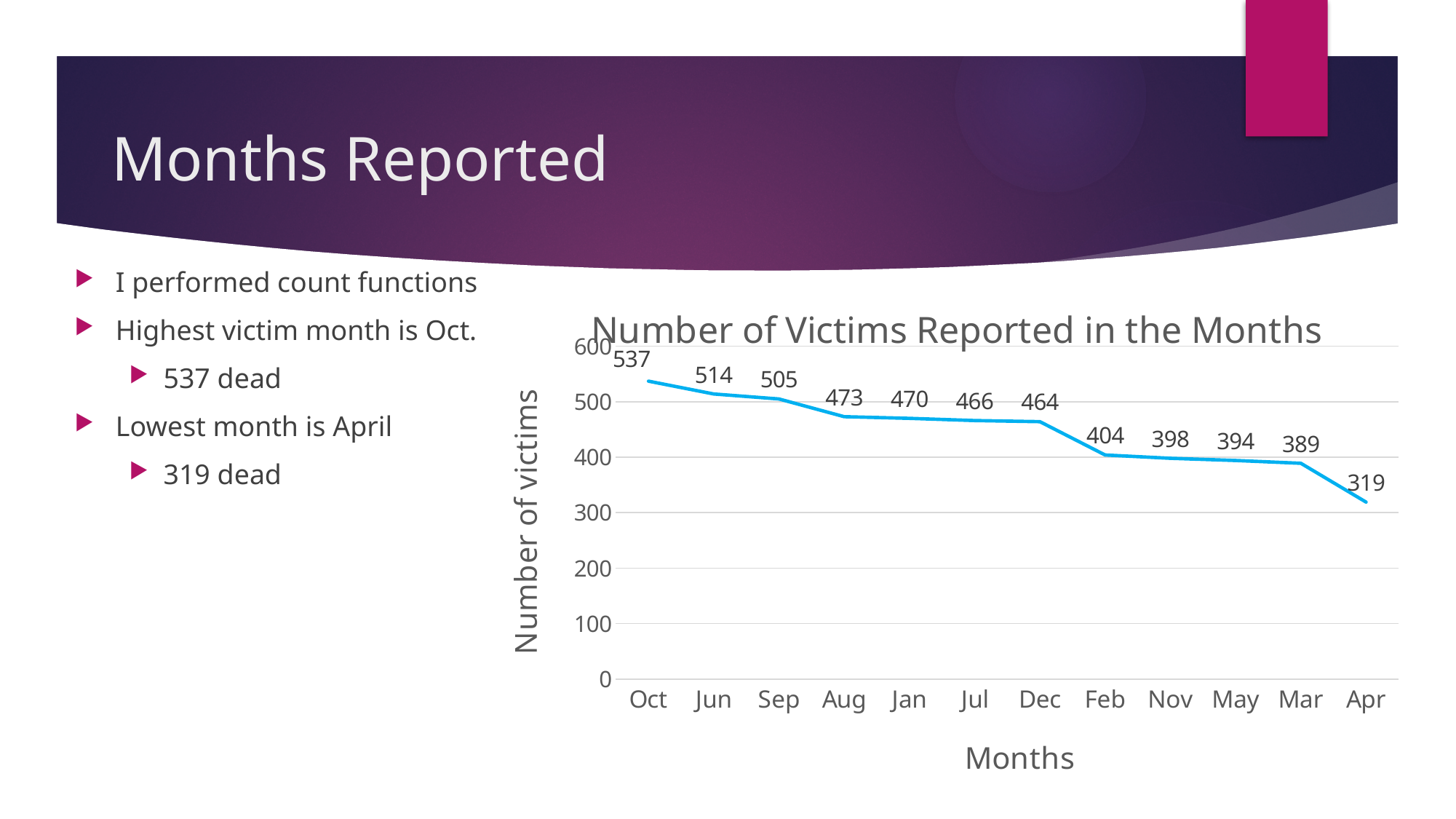
What kind of chart is shown on the slide? line chart What is the difference between the number of victims reported in Dec and in Feb? 60 Is the value for Jan greater or less than 400? greater What is the number of victims reported for Feb? 404 Do the values rise or fall from left to right along the x axis? fall Which month has the highest number of victims reported? Oct What is the number of victims reported for Mar? 389 What is the difference between the number of victims reported in Oct and in Apr? 218 What is the number of victims reported for Oct? 537 Which month has the lowest number of victims reported? Apr Which has more victims reported, Sep or Nov? Sep How many months are plotted on the chart? 12